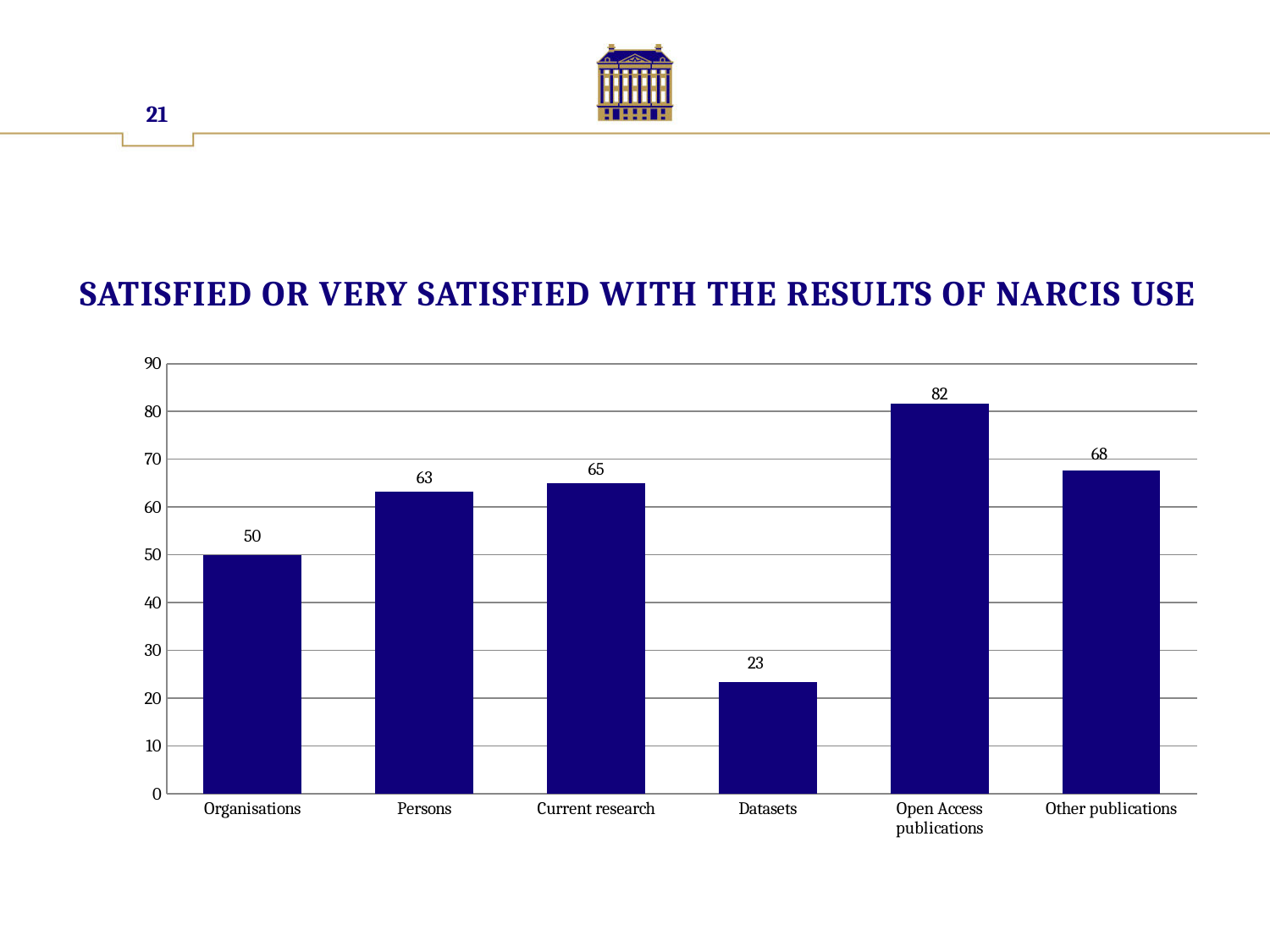
What is the value for Other publications? 68 What is the difference between the values for Open Access publications and Datasets? 59 What is the value for Open Access publications? 82 What kind of chart is shown on the slide? Bar chart Which category has the lowest value? Datasets Which is larger, the value for Other publications or the value for Current research? Other publications What is the title of the chart? Satisfied or very satisfied with the results of NARCIS use What is the value for Datasets? 23 What is the difference between the values for Persons and Organisations? 13 Which category has the highest value? Open Access publications How many categories are shown on the x axis? 6 What is the value for Organisations? 50